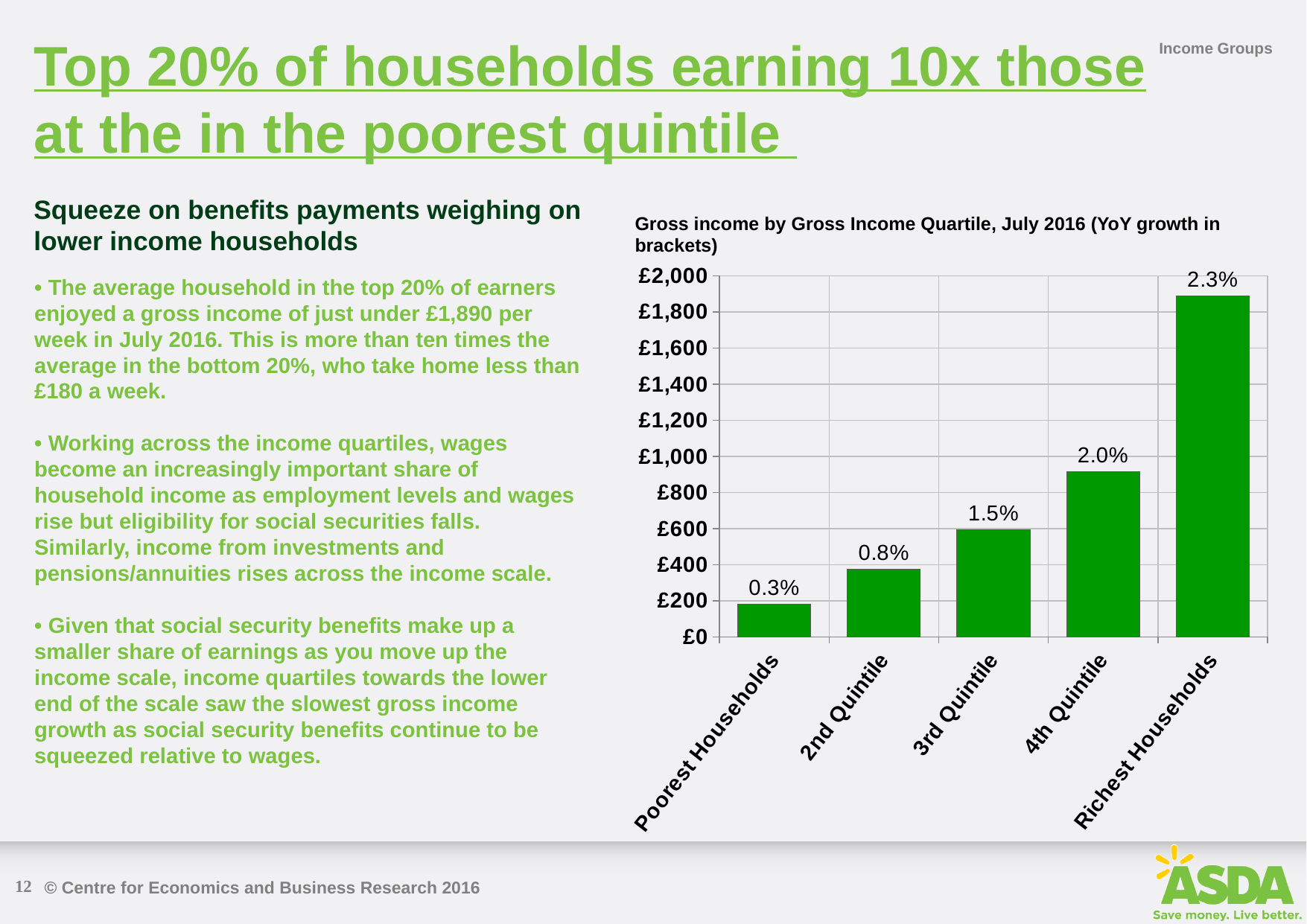
What kind of chart is shown on the slide? Bar chart What YoY growth figure is labelled on the bar for Poorest Households? 0.3% What YoY growth figure is labelled on the bar for Richest Households? 2.3% Which income group has the highest gross income in the chart? Richest Households What YoY growth figure is labelled on the bar for the 2nd Quintile? 0.8% What YoY growth figure is labelled on the bar for the 3rd Quintile? 1.5% Which income group has the lowest gross income in the chart? Poorest Households Is the gross income value for Richest Households greater or less than £1,800? greater Is the gross income value for the 4th Quintile greater or less than £1,000? less How many income groups are shown on the x axis of the chart? 5 What YoY growth figure is labelled on the bar for the 4th Quintile? 2.0% Do the gross income values rise or fall moving from Poorest Households to Richest Households along the x axis? Rise